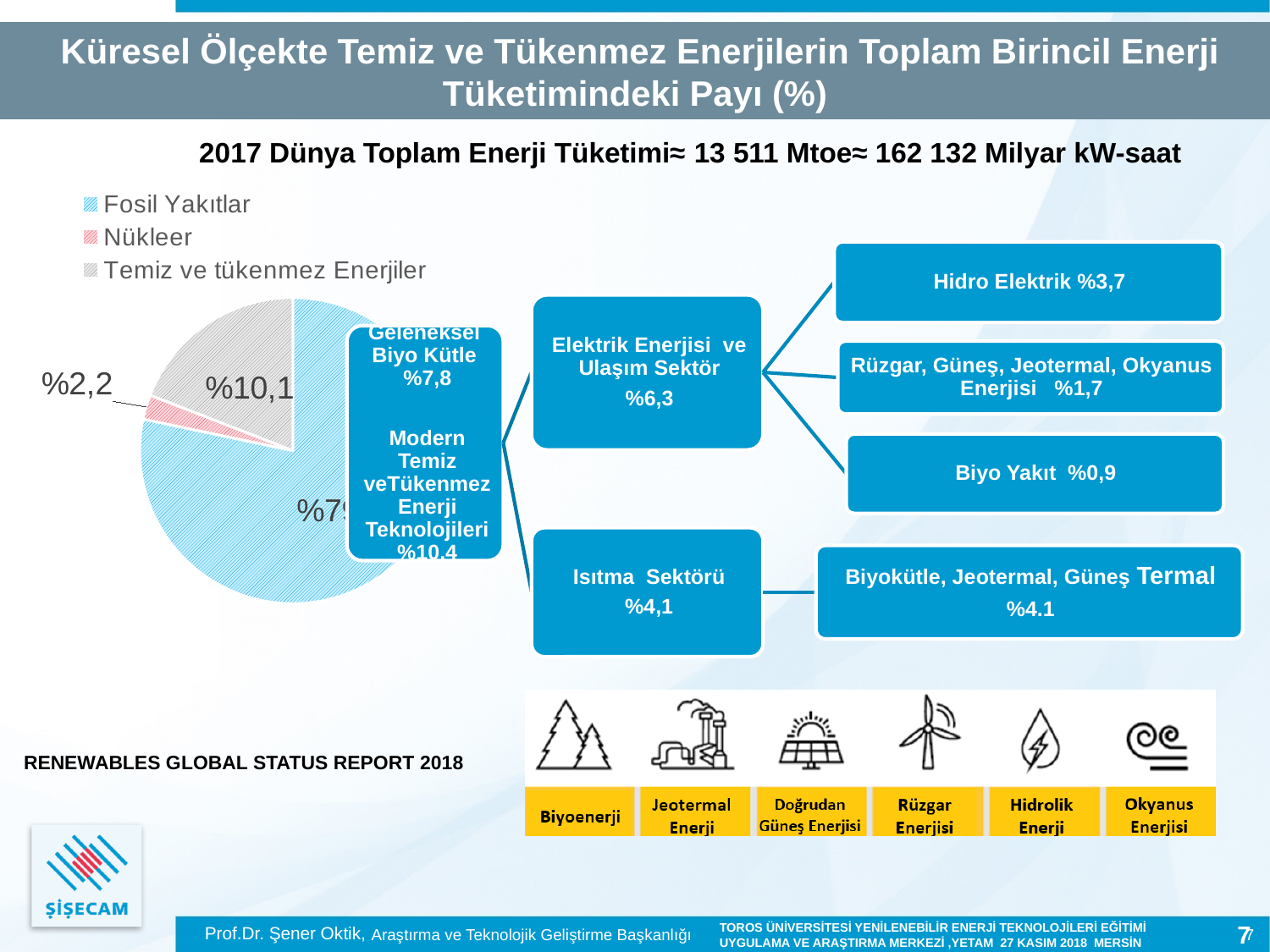
Which category has the smallest slice in the pie chart? Nükleer What is the value shown for Nükleer in the pie chart? %2,2 How many slices does the pie chart have? 3 What is the value shown for Temiz ve tükenmez Enerjiler in the pie chart? %10,1 Which is larger in the pie chart, Temiz ve tükenmez Enerjiler or Nükleer? Temiz ve tükenmez Enerjiler Which legend entry is listed first in the pie chart's legend? Fosil Yakıtlar What is the difference between the values for Temiz ve tükenmez Enerjiler and Nükleer in the pie chart? %7,9 Which category has the largest slice in the pie chart? Fosil Yakıtlar What kind of chart is shown on the slide? pie chart Is the value for Fosil Yakıtlar in the pie chart greater or less than 50%? greater How many entries does the pie chart's legend list? 3 Which legend entry is listed last in the pie chart's legend? Temiz ve tükenmez Enerjiler